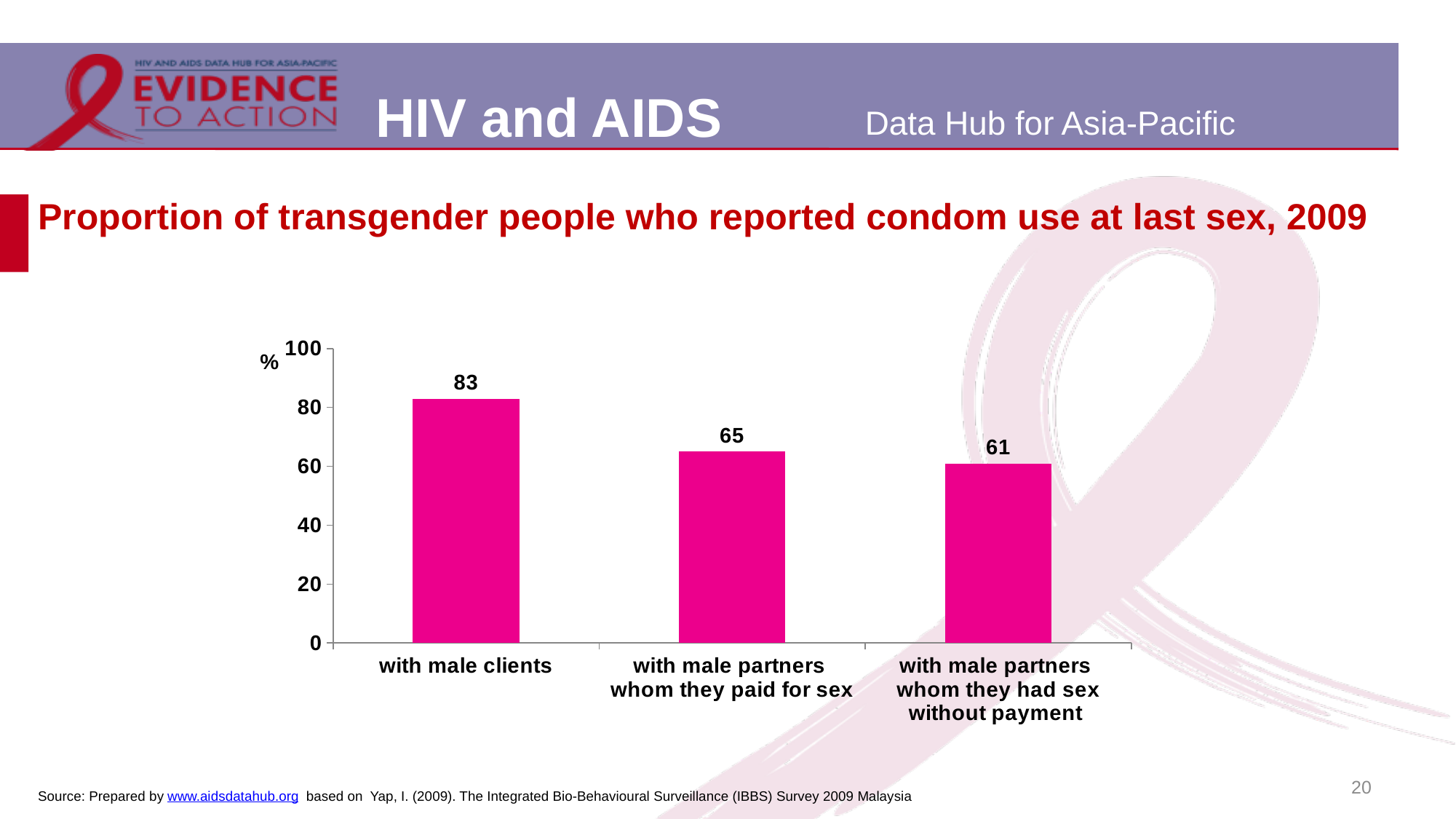
What kind of chart is shown on the slide? bar chart What is the value for 'with male clients'? 83 Is the value for 'with male partners whom they paid for sex' greater or less than 60? greater What is the difference between the value for 'with male partners whom they paid for sex' and the value for 'with male partners whom they had sex without payment'? 4 Do the values rise or fall from left to right across the categories? fall Which is larger: the value for 'with male clients' or the value for 'with male partners whom they had sex without payment'? with male clients Which category has the lowest value? with male partners whom they had sex without payment What is the difference between the value for 'with male clients' and the value for 'with male partners whom they paid for sex'? 18 Which category has the highest value? with male clients How many categories are shown on the chart? 3 What is the value for 'with male partners whom they paid for sex'? 65 What is the value for 'with male partners whom they had sex without payment'? 61